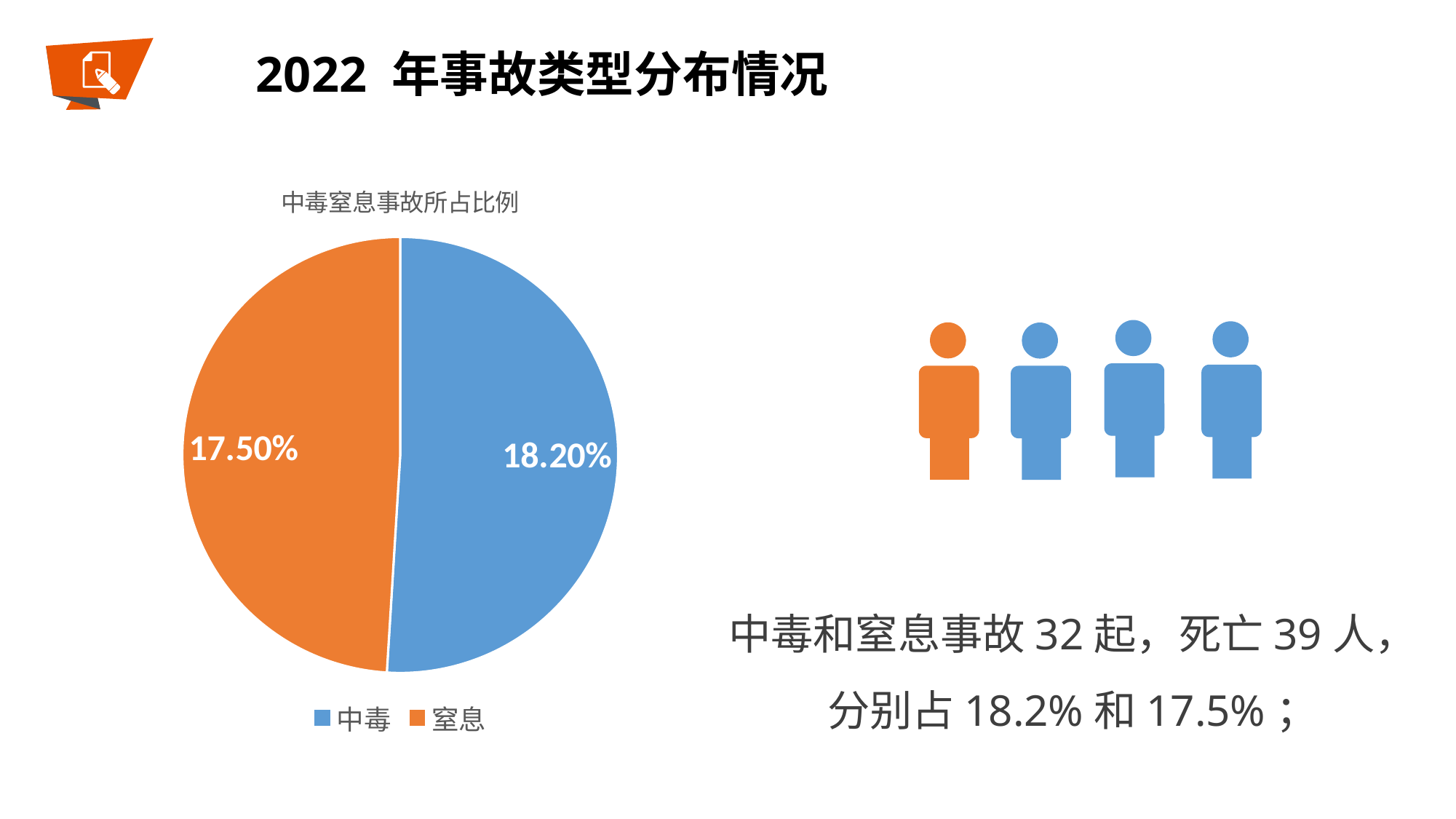
Which colour represents 窒息 in the pie chart? orange Is the labelled value for 中毒 larger or smaller than the labelled value for 窒息? larger Which category has the larger labelled value in the pie chart? 中毒 What value is labelled on the 窒息 slice of the pie chart? 17.50% Which category has the smaller labelled value in the pie chart? 窒息 What is the title of the pie chart? 中毒窒息事故所占比例 How many entries does the legend of the pie chart list? 2 What value is labelled on the 中毒 slice of the pie chart? 18.20% What type of chart is shown on the slide? pie chart What is the difference between the labelled values for 中毒 and 窒息 in the pie chart? 0.70% How many slices does the pie chart have? 2